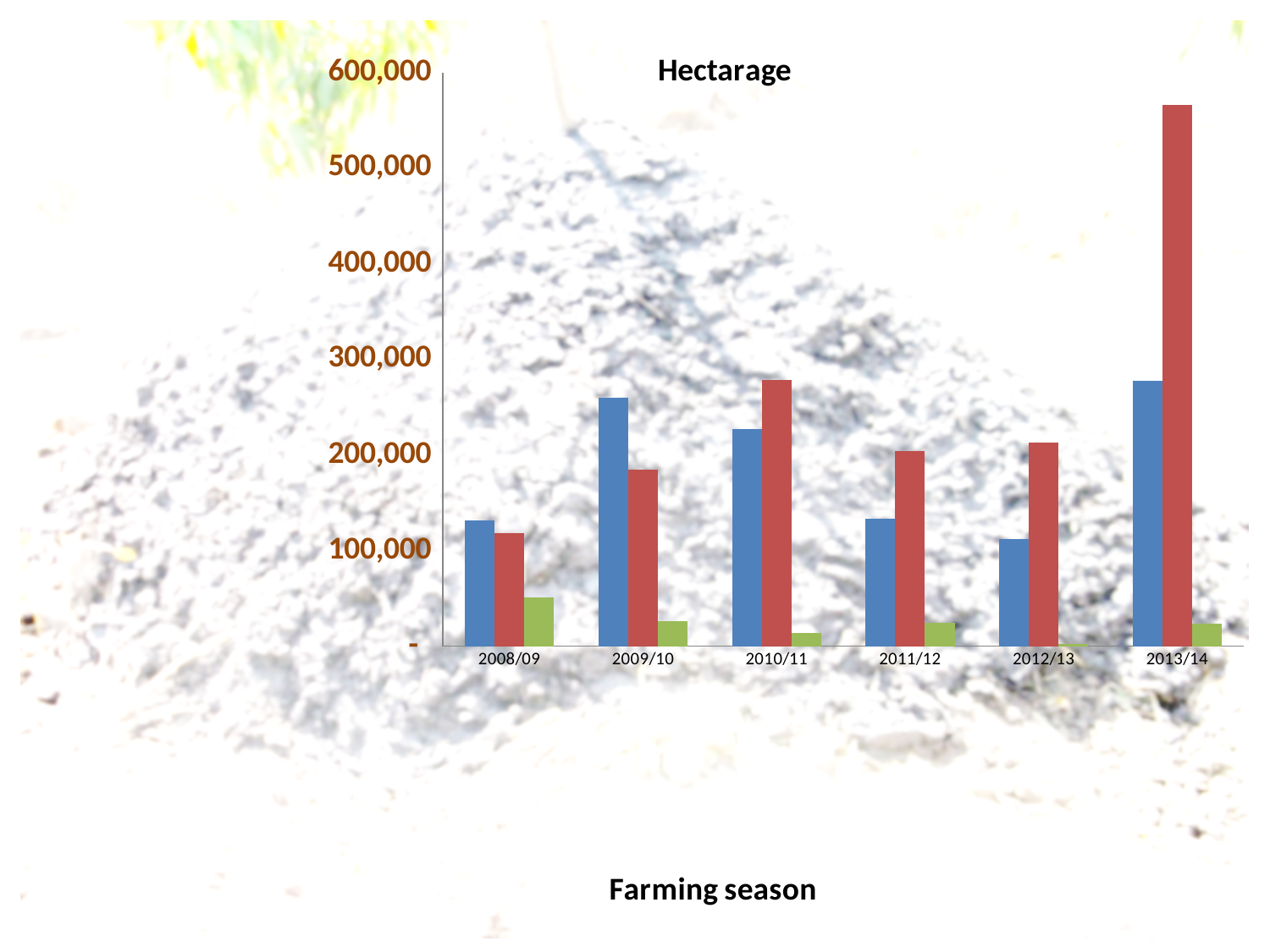
How many farming seasons are shown on the x axis of the chart? 6 What kind of chart is shown on the slide? bar chart Is the red bar for 2013/14 greater or less than 500,000? greater What is the title of the chart? Hectarage Is the green bar for 2008/09 greater or less than 100,000? less How many bars are plotted for each farming season? 3 Which farming season has the tallest red bar? 2013/14 Which farming season has the shortest blue bar? 2012/13 In 2010/11, which bar is taller, the blue bar or the red bar? red What is the x-axis title of the chart? Farming season In 2009/10, which bar is taller, the blue bar or the red bar? blue Is the blue bar for 2009/10 greater or less than 200,000? greater